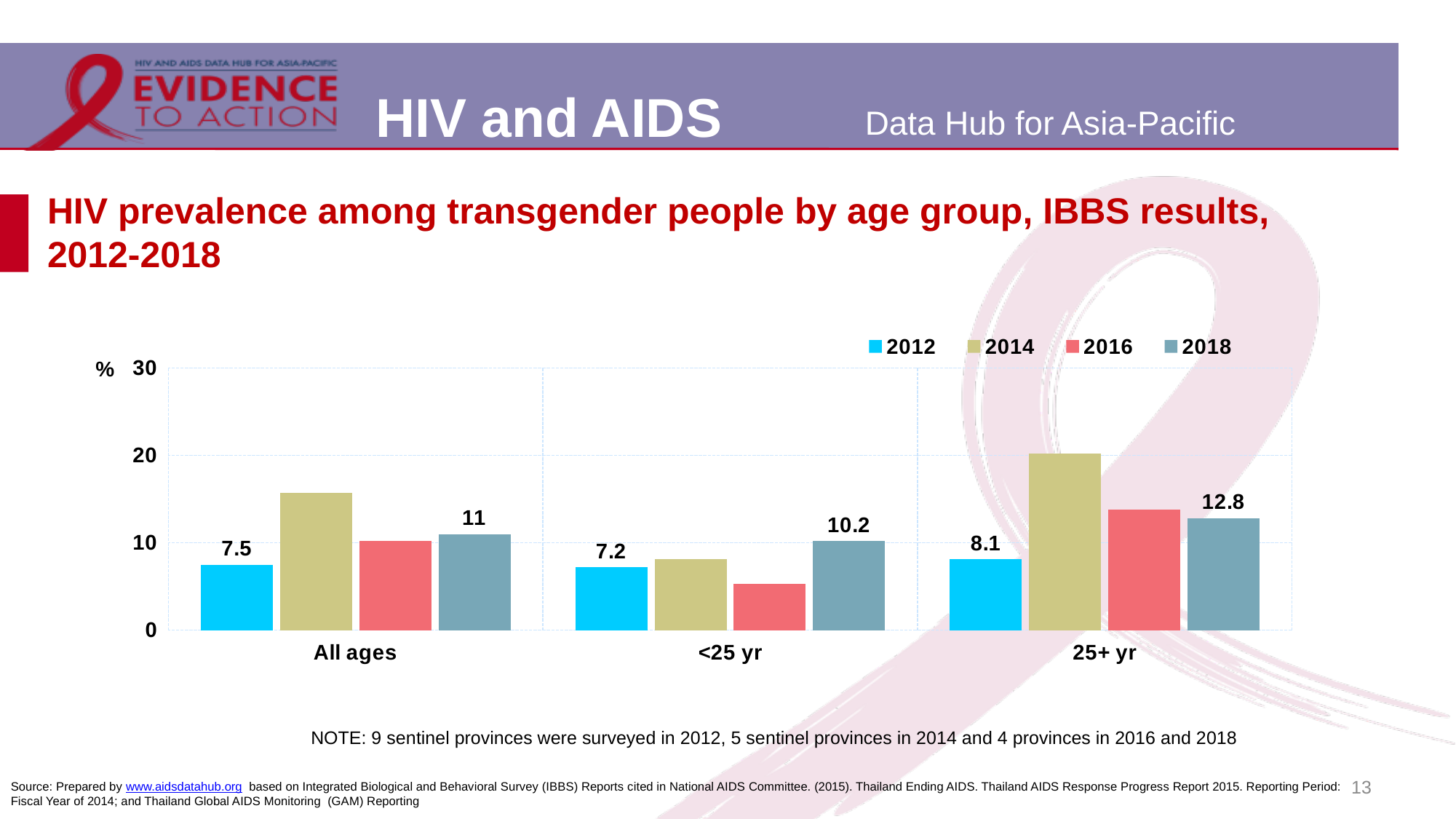
How many series does the legend list? 4 For 2012, which is larger: the value for <25 yr or the value for 25+ yr? 25+ yr What kind of chart is shown on the slide? bar chart What is the difference between the 2018 and 2012 values for the 25+ yr group? 4.7 What is the HIV prevalence for 2018 in the <25 yr group? 10.2 Which age group has the highest 2018 value? 25+ yr How many age groups are shown on the x axis? 3 Which age group has the lowest 2012 value? <25 yr What is the HIV prevalence for 2012 in the 25+ yr group? 8.1 Is the 2016 value for the <25 yr group greater or less than 10? less What is the HIV prevalence for 2018 in the 25+ yr group? 12.8 What is the HIV prevalence for 2012 in the All ages group? 7.5